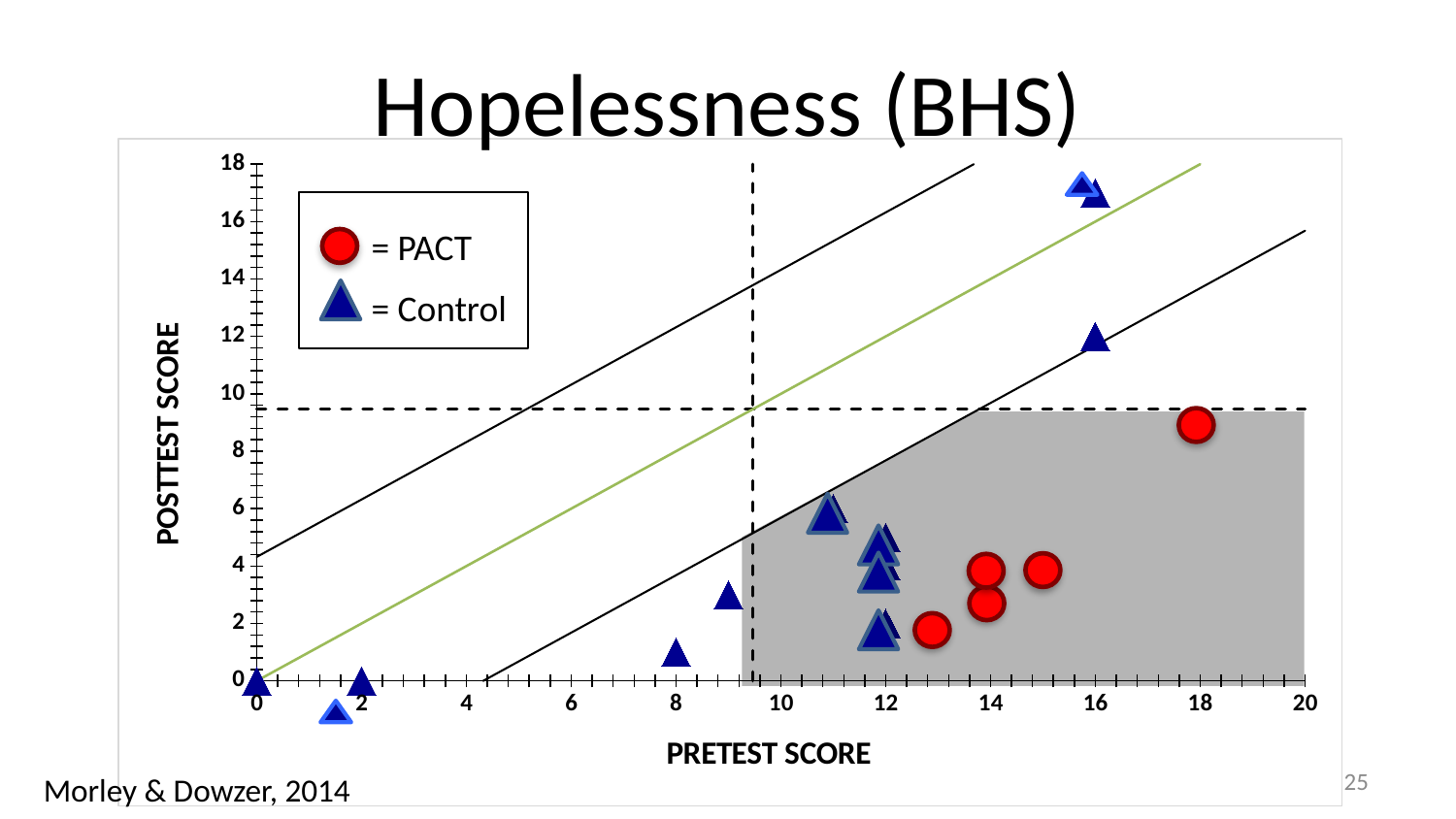
How many series does the legend list? 2 Is the posttest score of the Control point with a pretest score of about 16 that lies above the grey region greater or less than 10? greater Is the posttest score of the highest Control point greater or less than 16? greater Is the posttest score of the Control point with a pretest score of 8 greater or less than 2? less What is the label of the horizontal axis? PRETEST SCORE Which series contains the point with the highest posttest score? Control Which marker shape represents the PACT group in the legend? Red circle What kind of chart is shown on the slide? Scatter plot How many PACT (red circle) data points are plotted? 5 What is the maximum value shown on the PRETEST SCORE axis? 20 Which has the higher posttest score: the PACT point at a pretest score of about 18 or the PACT point at a pretest score of about 13? The PACT point at a pretest score of about 18